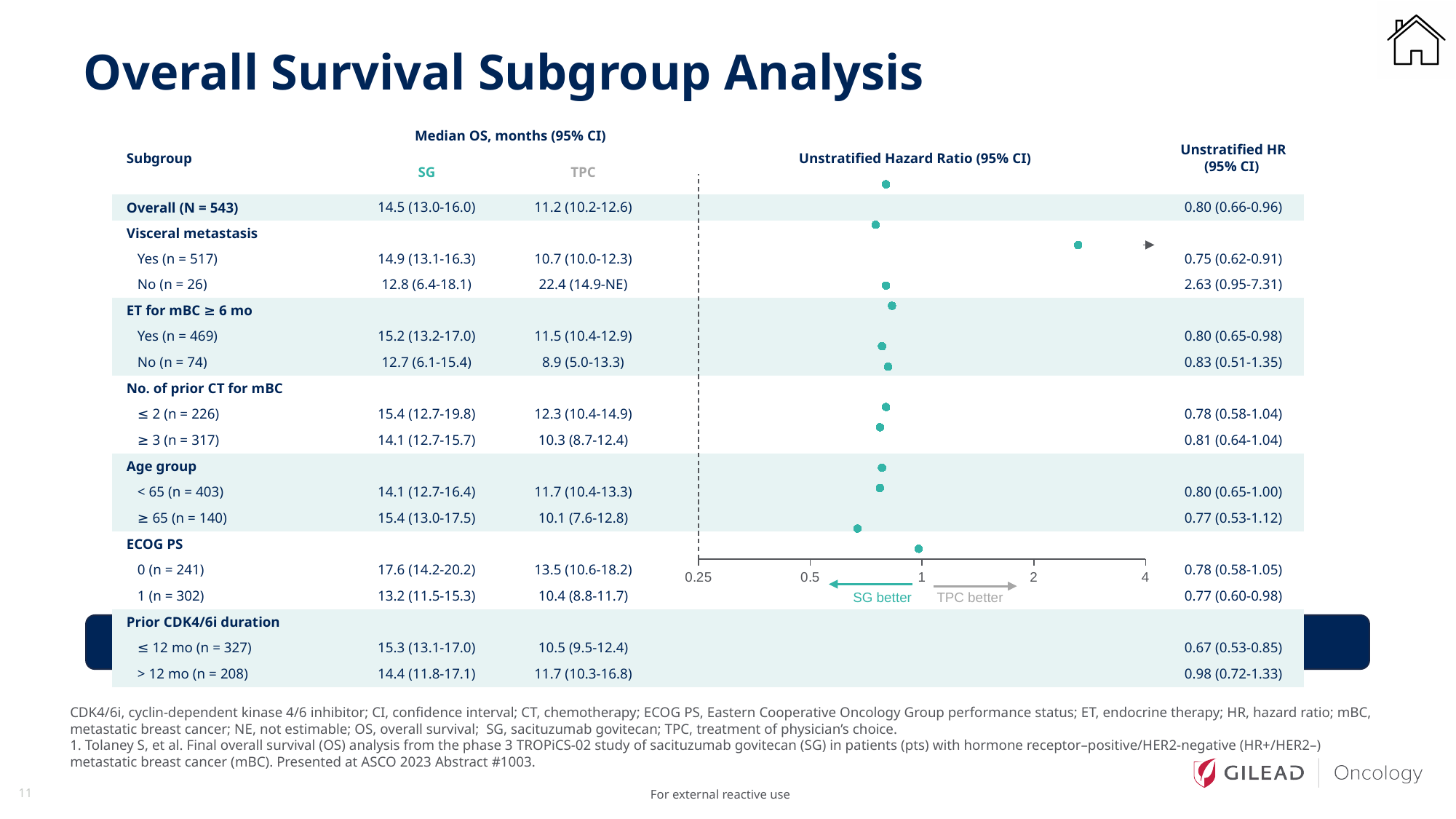
What kind of chart is used to display the unstratified hazard ratios? Forest plot What is the unstratified hazard ratio (95% CI) for the Overall (N = 543) group? 0.80 (0.66-0.96) Which has the larger unstratified hazard ratio: Prior CDK4/6i duration ≤ 12 mo or > 12 mo? > 12 mo Which subgroup has the lowest unstratified hazard ratio? Prior CDK4/6i duration ≤ 12 mo (n = 327) Which subgroup has the highest unstratified hazard ratio? Visceral metastasis No (n = 26) Which direction on the hazard ratio axis is labelled as favouring SG? Left (SG better) What tick values are shown on the hazard ratio axis? 0.25, 0.5, 1, 2, 4 Is the unstratified hazard ratio for the Visceral metastasis No (n = 26) subgroup greater or less than 2? greater What is the difference between the unstratified hazard ratio for Prior CDK4/6i duration > 12 mo and ≤ 12 mo? 0.31 How many hazard ratio points are plotted in the forest plot? 13 What is the unstratified hazard ratio (95% CI) for the Age group ≥ 65 (n = 140) subgroup? 0.77 (0.53-1.12) What is the unstratified hazard ratio (95% CI) for the Visceral metastasis No (n = 26) subgroup? 2.63 (0.95-7.31)